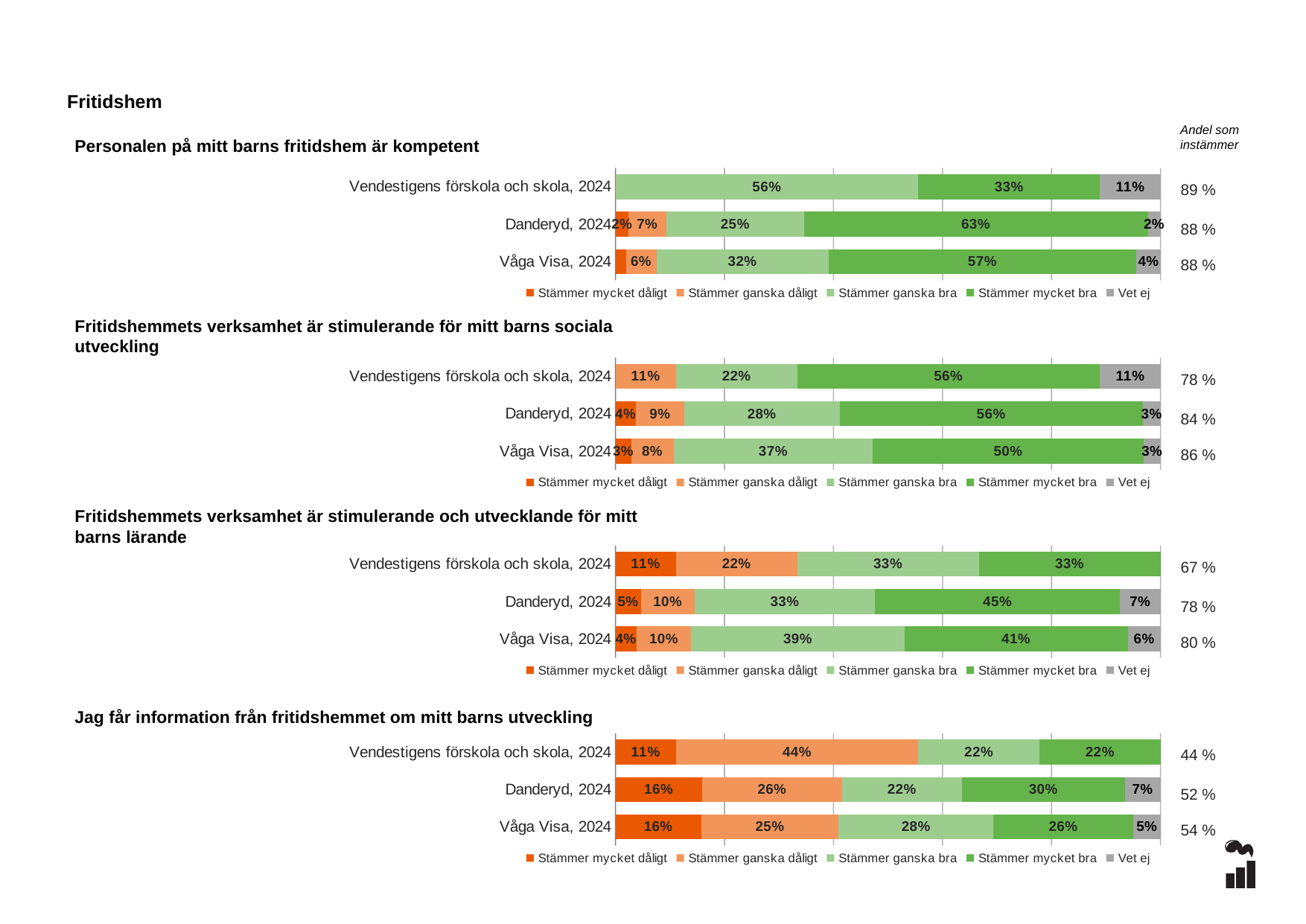
In the chart 'Personalen på mitt barns fritidshem är kompetent', what is the 'Vet ej' value for Vendestigens förskola och skola, 2024? 11% In the chart 'Fritidshemmets verksamhet är stimulerande och utvecklande för mitt barns lärande', what is the difference between the 'Stämmer mycket bra' values for Danderyd, 2024 and Våga Visa, 2024? 4% In the chart 'Fritidshemmets verksamhet är stimulerande och utvecklande för mitt barns lärande', what is the 'Stämmer mycket dåligt' value for Vendestigens förskola och skola, 2024? 11% How many series does the legend list in the chart 'Personalen på mitt barns fritidshem är kompetent'? 5 In the chart 'Personalen på mitt barns fritidshem är kompetent', what is the 'Stämmer mycket bra' value for Danderyd, 2024? 63% What kind of chart is used for 'Fritidshemmets verksamhet är stimulerande för mitt barns sociala utveckling'? Stacked bar chart How many rows (categories) are shown in the chart 'Jag får information från fritidshemmet om mitt barns utveckling'? 3 In the chart 'Fritidshemmets verksamhet är stimulerande för mitt barns sociala utveckling', what is the 'Stämmer ganska bra' value for Våga Visa, 2024? 37% In the chart 'Jag får information från fritidshemmet om mitt barns utveckling', which row has the lowest 'Stämmer mycket bra' value? Vendestigens förskola och skola, 2024 In the chart 'Jag får information från fritidshemmet om mitt barns utveckling', is the 'Stämmer mycket bra' value larger for Danderyd, 2024 or Våga Visa, 2024? Danderyd, 2024 In the chart 'Jag får information från fritidshemmet om mitt barns utveckling', what is the 'Stämmer ganska dåligt' value for Vendestigens förskola och skola, 2024? 44% In the chart 'Fritidshemmets verksamhet är stimulerande för mitt barns sociala utveckling', which row has the highest 'Stämmer ganska dåligt' value? Vendestigens förskola och skola, 2024